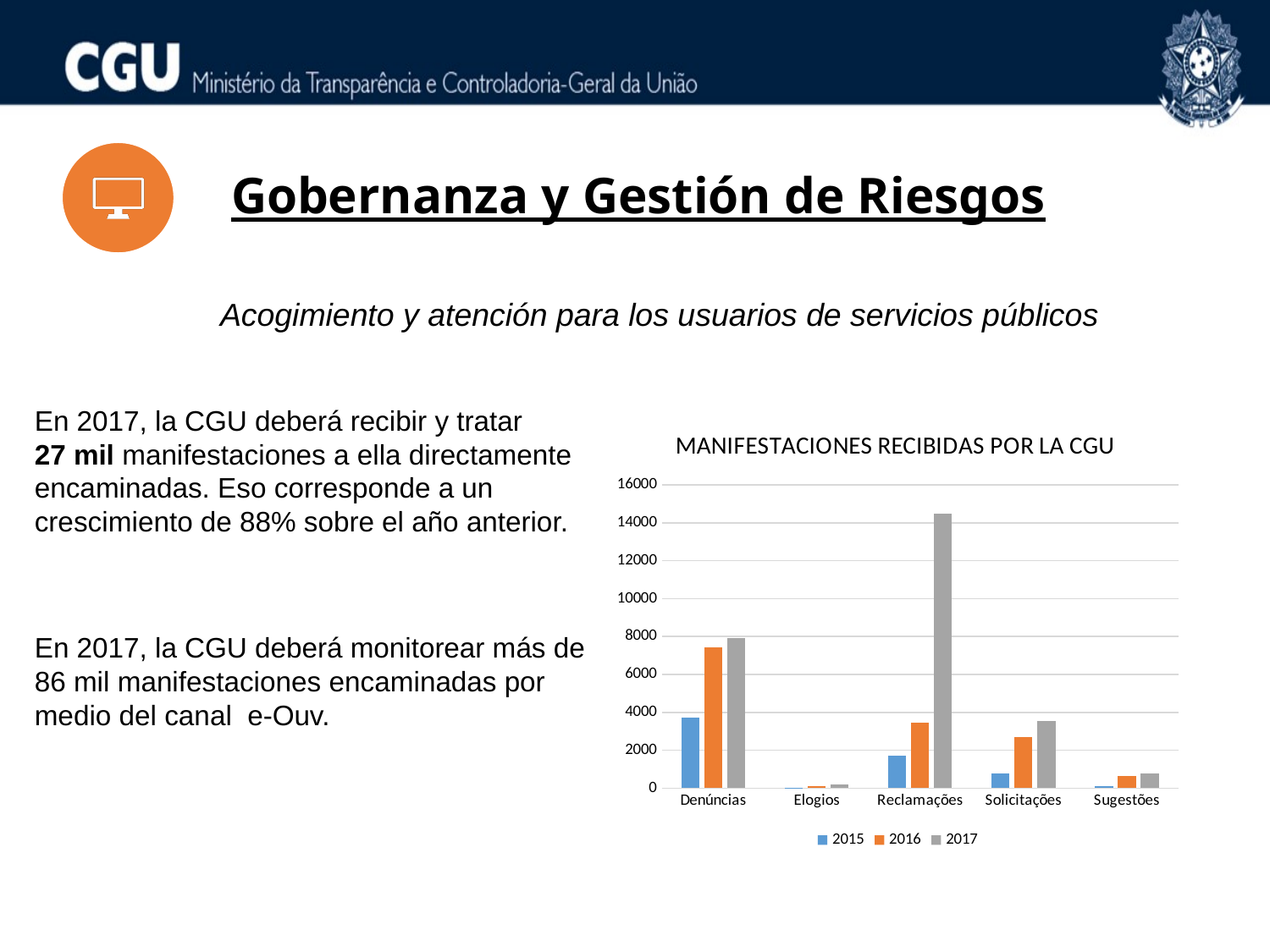
Which category has the lowest value for 2017? Elogios Is the 2017 value for Reclamações greater or less than 14000? greater What kind of chart is shown on the slide? Bar chart Which is larger for 2017: Denúncias or Reclamações? Reclamações Is the 2017 value for Solicitações greater or less than 4000? less How many series does the legend of the chart list? 3 How many categories are shown on the x axis of the chart? 5 Which is larger for 2015: Denúncias or Reclamações? Denúncias Is the 2016 value for Denúncias greater or less than 8000? less What is the title of the chart? MANIFESTACIONES RECIBIDAS POR LA CGU Which category has the highest value for 2017? Reclamações Which years are listed in the chart's legend? 2015, 2016, 2017